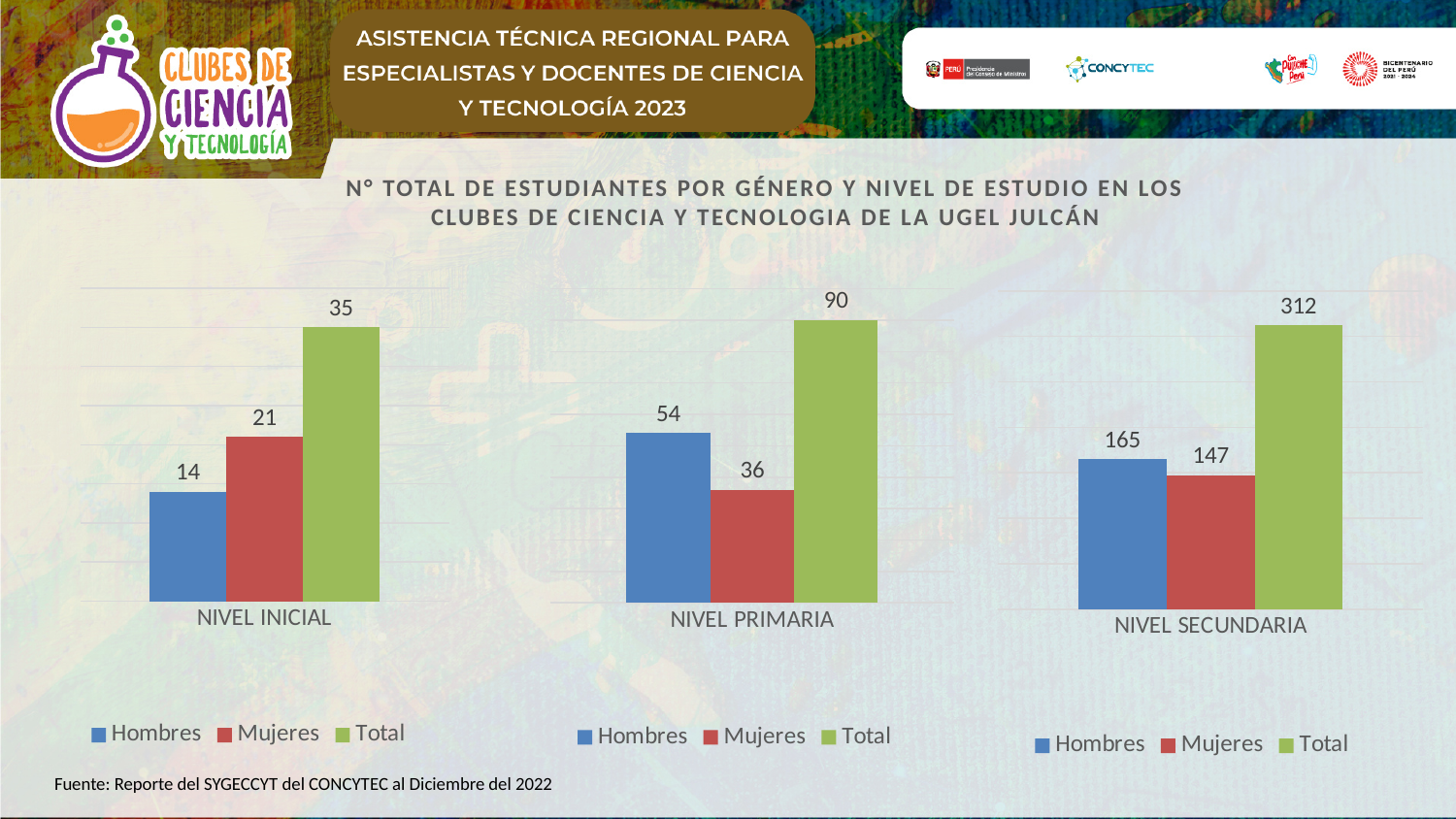
In the NIVEL INICIAL chart on the left, what is the value for Mujeres? 21 How many series does the legend of the NIVEL INICIAL chart on the left list? 3 In the NIVEL INICIAL chart on the left, which is larger, Hombres or Mujeres? Mujeres In the NIVEL PRIMARIA chart in the middle, what colour is the Total bar? Green What kind of chart is the NIVEL SECUNDARIA chart on the right? Bar chart In the NIVEL SECUNDARIA chart on the right, what is the value for Hombres? 165 In the NIVEL SECUNDARIA chart on the right, what is the value for Mujeres? 147 In the NIVEL INICIAL chart on the left, what is the value for Hombres? 14 In the NIVEL PRIMARIA chart in the middle, what is the difference between Hombres and Mujeres? 18 In the NIVEL PRIMARIA chart in the middle, which series has the lowest value? Mujeres In the NIVEL SECUNDARIA chart on the right, what is the difference between Hombres and Mujeres? 18 In the NIVEL PRIMARIA chart in the middle, what is the value for Total? 90